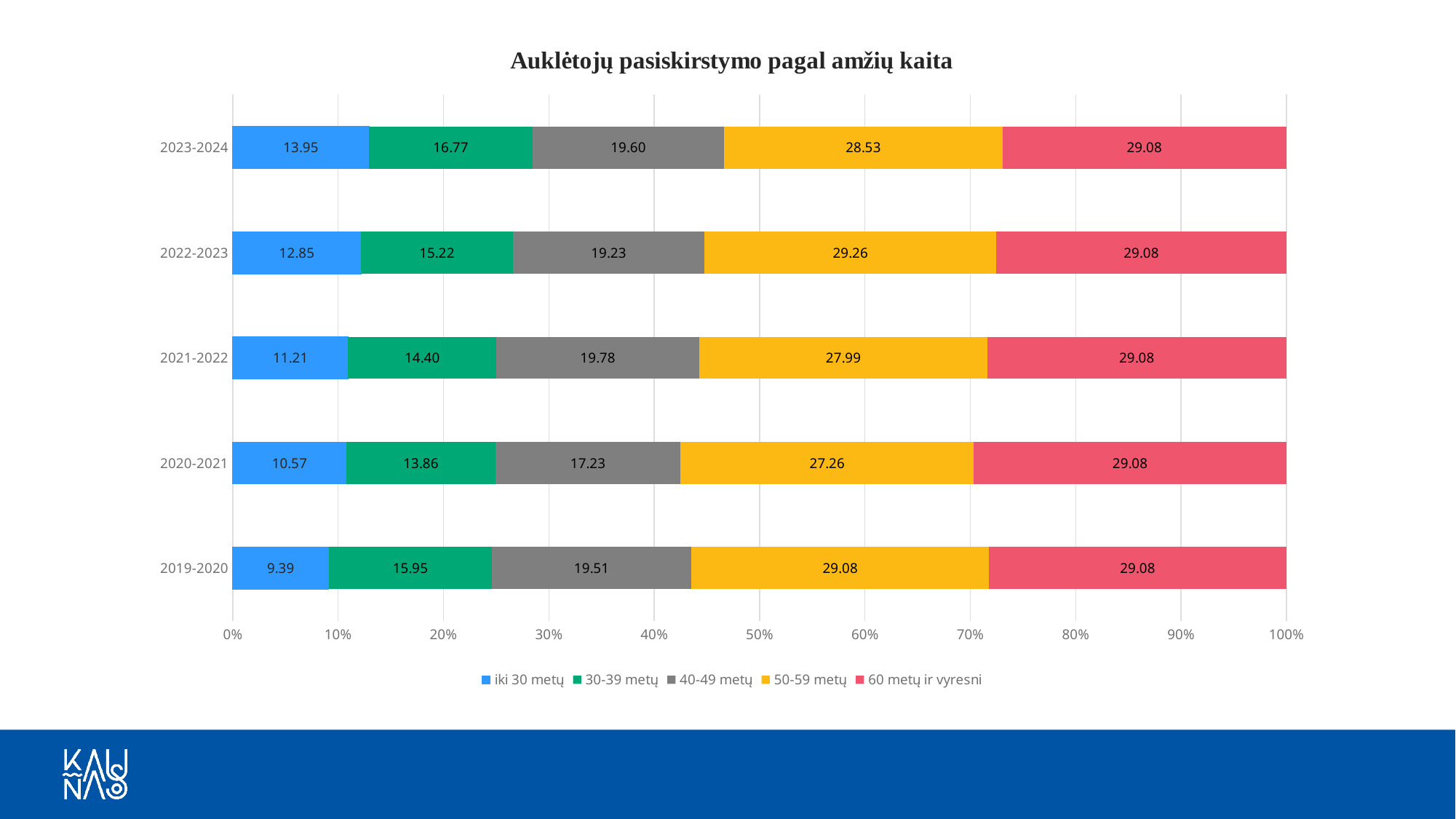
Which is larger, the '30-39 metų' value for 2022-2023 or for 2019-2020? 2019-2020 How many series does the legend list? 5 What is the value for '40-49 metų' in 2020-2021? 17.23 Which year has the highest value for 'iki 30 metų'? 2023-2024 What is the value for '50-59 metų' in 2022-2023? 29.26 Does the 'iki 30 metų' value rise or fall from 2019-2020 to 2023-2024? Rise Which year has the lowest value for 'iki 30 metų'? 2019-2020 What is the value for 'iki 30 metų' in 2023-2024? 13.95 What is the title of the chart? Auklėtojų pasiskirstymo pagal amžių kaita How many year categories are shown on the chart? 5 What kind of chart is shown on the slide? Stacked bar chart What is the difference between the 'iki 30 metų' values for 2023-2024 and 2019-2020? 4.56